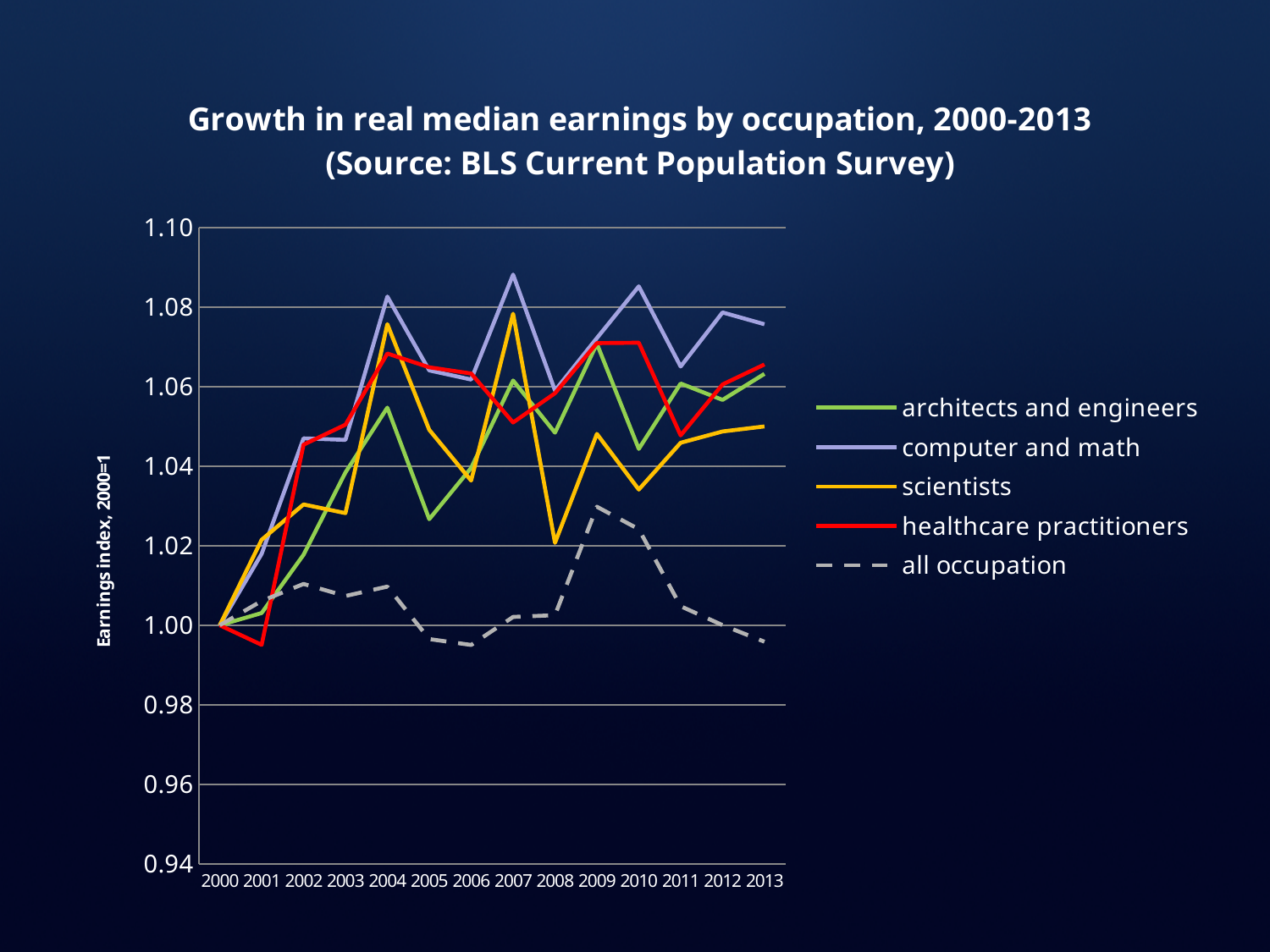
Is the value for healthcare practitioners in 2001 greater or less than 1.00? less Does the all occupation series rise or fall from 2009 to 2013? fall What is the value of the computer and math series in 2000? 1.00 Is the value for computer and math in 2007 greater or less than 1.08? greater Which series is drawn with a dashed line? all occupation How many series does the legend list? 5 In 2010, which is larger: the value for computer and math or the value for scientists? computer and math How many years are shown along the x axis? 14 Which series has the lowest value in 2013? all occupation What kind of chart is shown on the slide? line chart Is the value for all occupation in 2013 greater or less than 1.00? less Which series has the highest value in 2013? computer and math